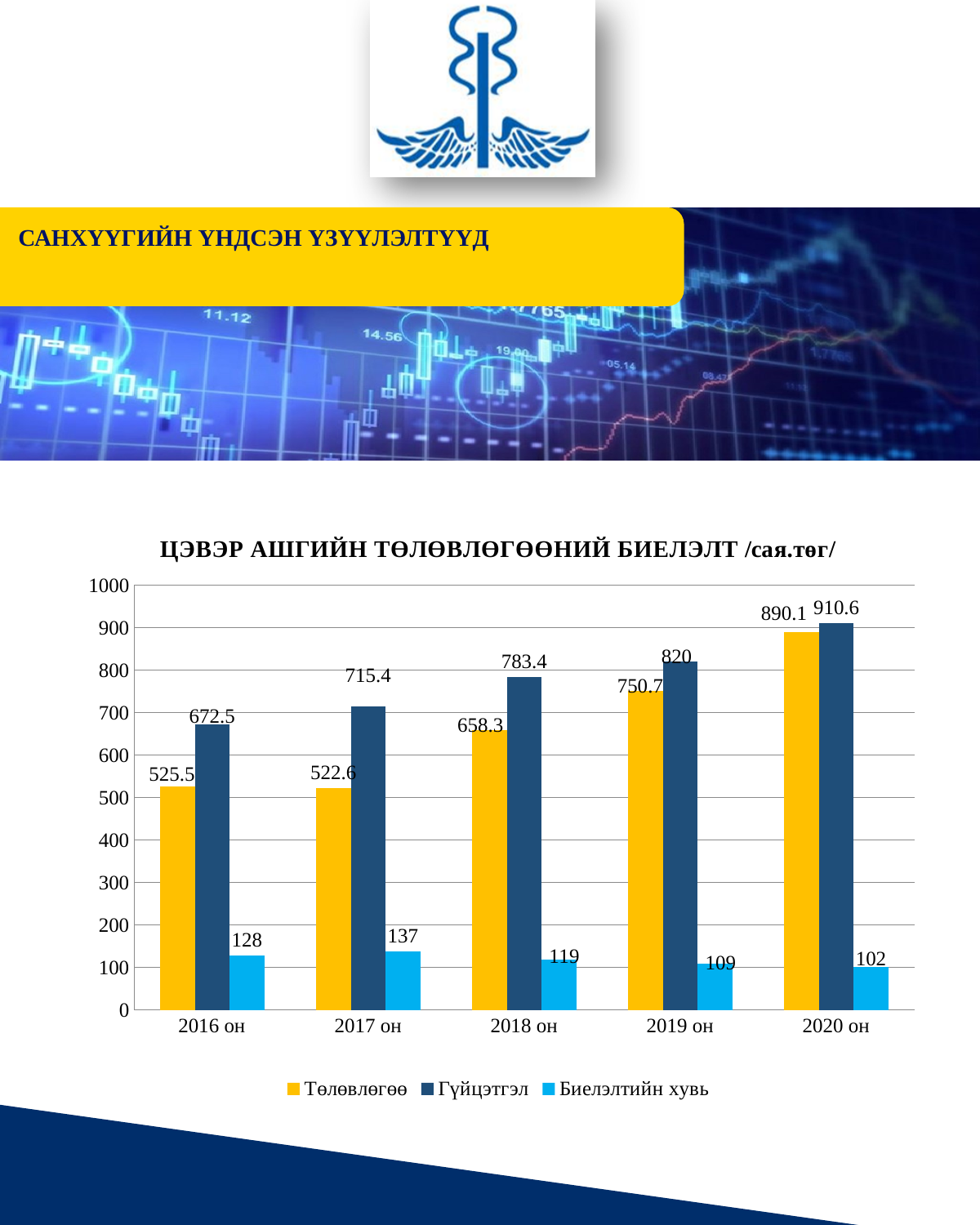
Which is larger for 2017 он: the Төлөвлөгөө value or the Гүйцэтгэл value? Гүйцэтгэл What is the Биелэлтийн хувь value for 2017 он? 137 What is the title of the chart? ЦЭВЭР АШГИЙН ТӨЛӨВЛӨГӨӨНИЙ БИЕЛЭЛТ /сая.төг/ What kind of chart is shown on the slide? Bar chart How many series does the legend list? 3 Which year has the highest Гүйцэтгэл value? 2020 он What is the Төлөвлөгөө value for 2016 он? 525.5 Does the Гүйцэтгэл value rise or fall from 2016 он to 2020 он? Rise What is the Гүйцэтгэл value for 2018 он? 783.4 What is the difference between the Гүйцэтгэл and Төлөвлөгөө values for 2019 он? 69.3 How many years are shown on the x axis? 5 Which year has the lowest Биелэлтийн хувь value? 2020 он